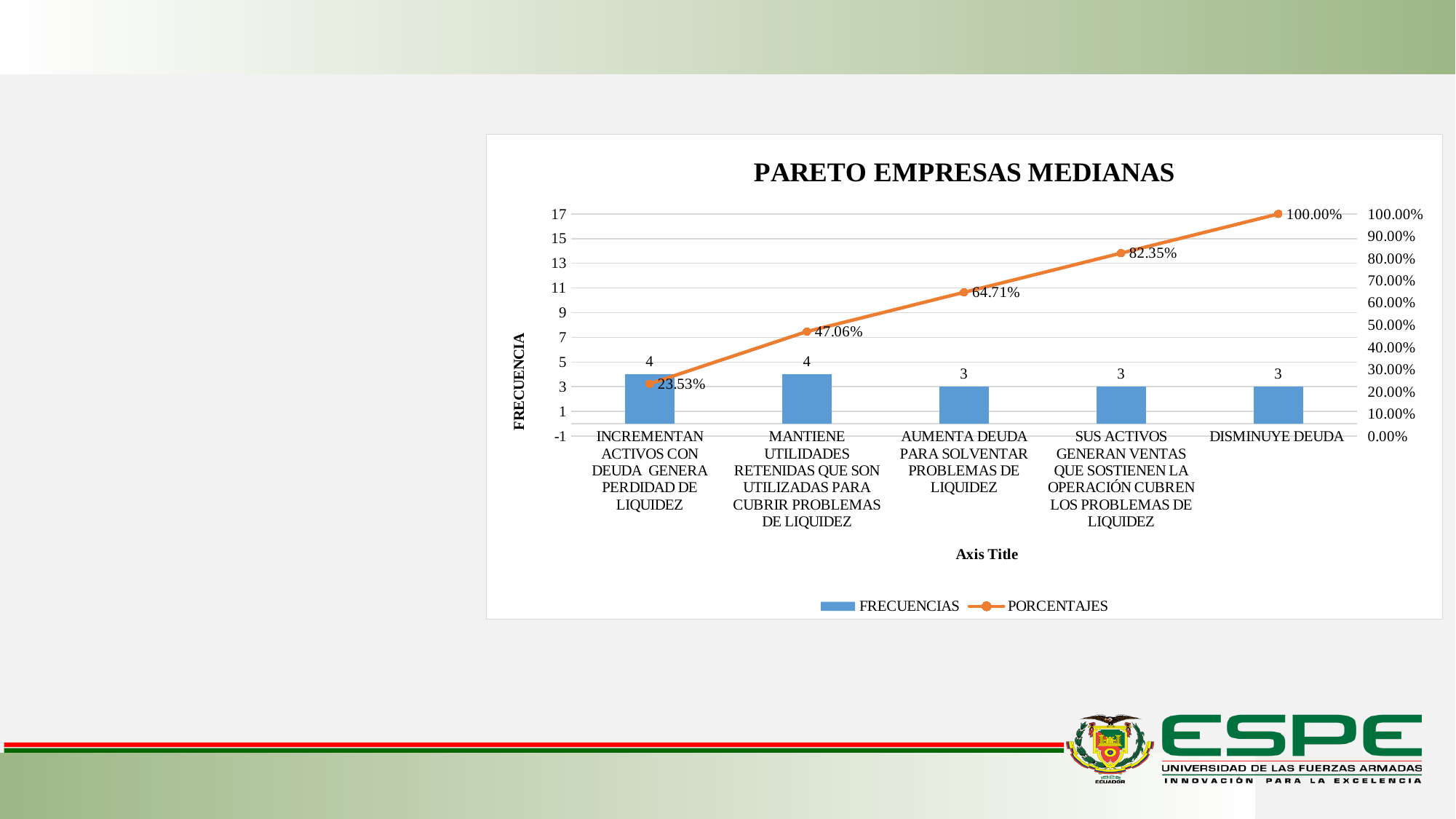
Does the PORCENTAJES line rise or fall from left to right along the x axis? rise How many series does the legend list? 2 What is the FRECUENCIAS value for DISMINUYE DEUDA? 3 What is the PORCENTAJES value for the first category, INCREMENTAN ACTIVOS CON DEUDA GENERA PERDIDAD DE LIQUIDEZ? 23.53% What is the FRECUENCIAS value for MANTIENE UTILIDADES RETENIDAS QUE SON UTILIZADAS PARA CUBRIR PROBLEMAS DE LIQUIDEZ? 4 What is the difference between the FRECUENCIAS values for INCREMENTAN ACTIVOS CON DEUDA GENERA PERDIDAD DE LIQUIDEZ and DISMINUYE DEUDA? 1 What is the PORCENTAJES value for AUMENTA DEUDA PARA SOLVENTAR PROBLEMAS DE LIQUIDEZ? 64.71% How many categories are shown on the x axis? 5 What is the title of the chart? PARETO EMPRESAS MEDIANAS What is the PORCENTAJES value for SUS ACTIVOS GENERAN VENTAS QUE SOSTIENEN LA OPERACIÓN CUBREN LOS PROBLEMAS DE LIQUIDEZ? 82.35% Which category has the highest PORCENTAJES value? DISMINUYE DEUDA What kind of chart is shown on the slide? Combined bar and line chart